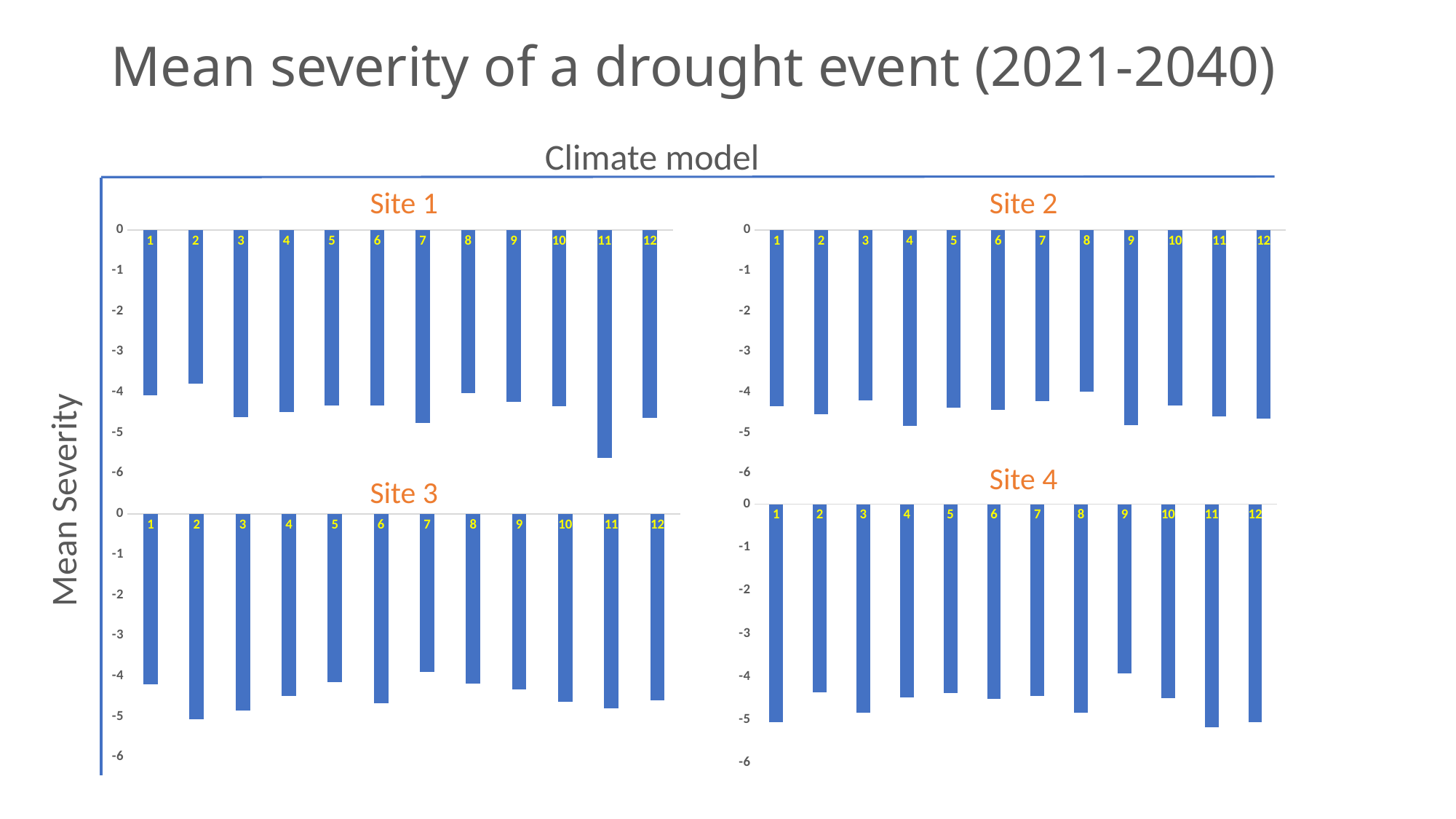
What kind of chart is used for Site 1? bar chart In the Site 1 chart, which climate model has the highest (least negative) mean severity? 2 In the Site 3 chart, which climate model has the highest (least negative) mean severity? 7 In the Site 1 chart, is the value for climate model 7 greater or less than -4? less In the Site 4 chart, is the value for climate model 11 greater or less than -5? less In the Site 1 chart, is the value for climate model 2 greater or less than -4? greater In the Site 1 chart, which climate model has the lowest (most negative) mean severity? 11 What is the label on the vertical axis shared by the four charts? Mean Severity What is the title of the slide? Mean severity of a drought event (2021-2040) In the Site 3 chart, which has the lower value, climate model 2 or climate model 7? climate model 2 How many climate models are plotted in the Site 1 chart? 12